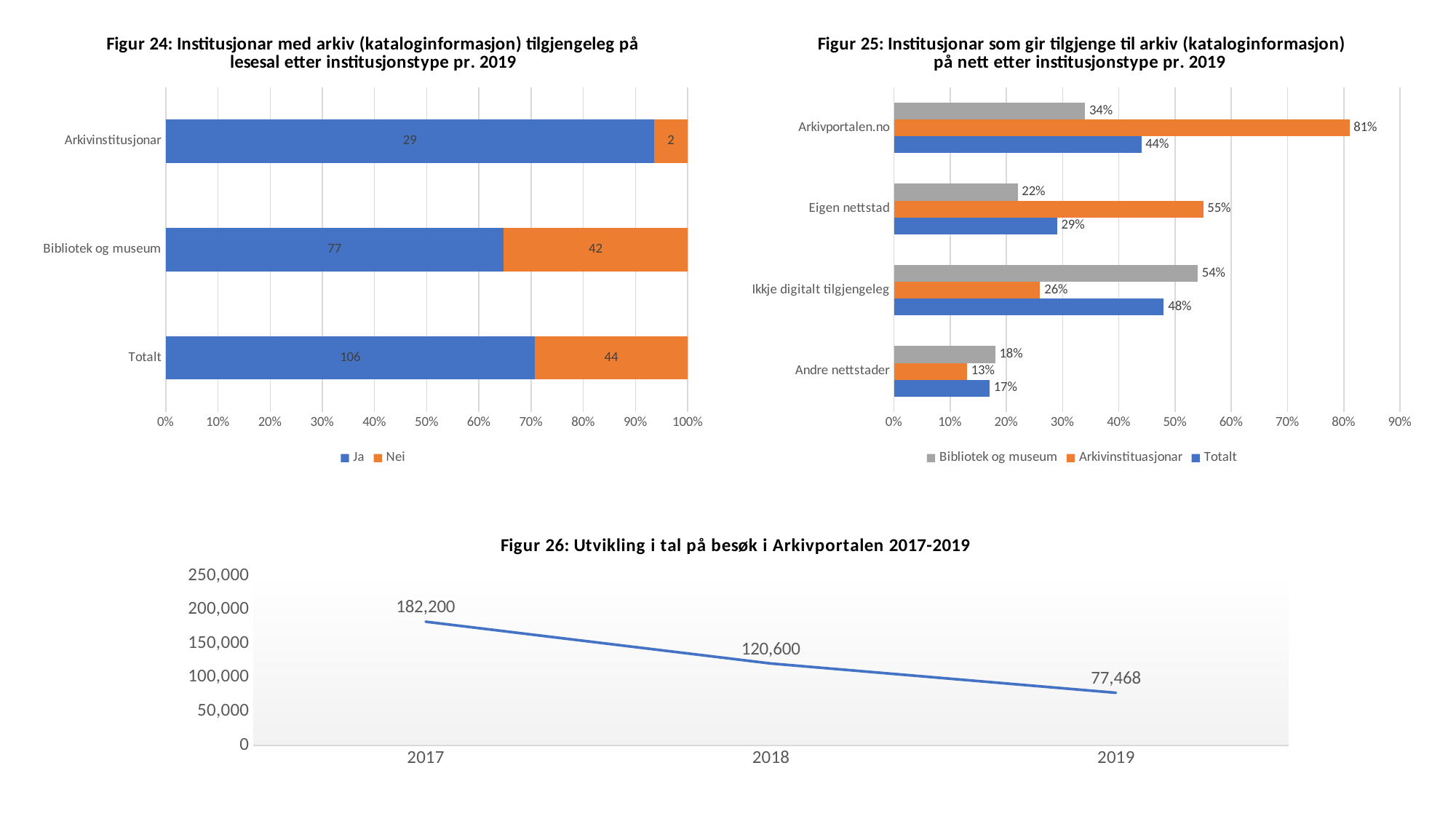
In Figur 26, what is the value for 2018? 120,600 In Figur 25, what is the Arkivinstituasjonar value for Arkivportalen.no? 81% What kind of chart is Figur 26? line chart In Figur 25, how many categories are shown on the vertical axis? 4 In Figur 26, do the values rise or fall from 2017 to 2019? fall In Figur 25, what is the difference between the Arkivinstituasjonar and Bibliotek og museum values for Eigen nettstad? 33% In Figur 25, which category has the highest Totalt value? Ikkje digitalt tilgjengeleg In Figur 24, how many series does the legend list? 2 In Figur 25, what is the Bibliotek og museum value for Ikkje digitalt tilgjengeleg? 54% In Figur 24, what is the 'Nei' value for Arkivinstitusjonar? 2 In Figur 24, what is the total of the Totalt bar (Ja plus Nei)? 150 In Figur 24, what is the 'Ja' value for Bibliotek og museum? 77